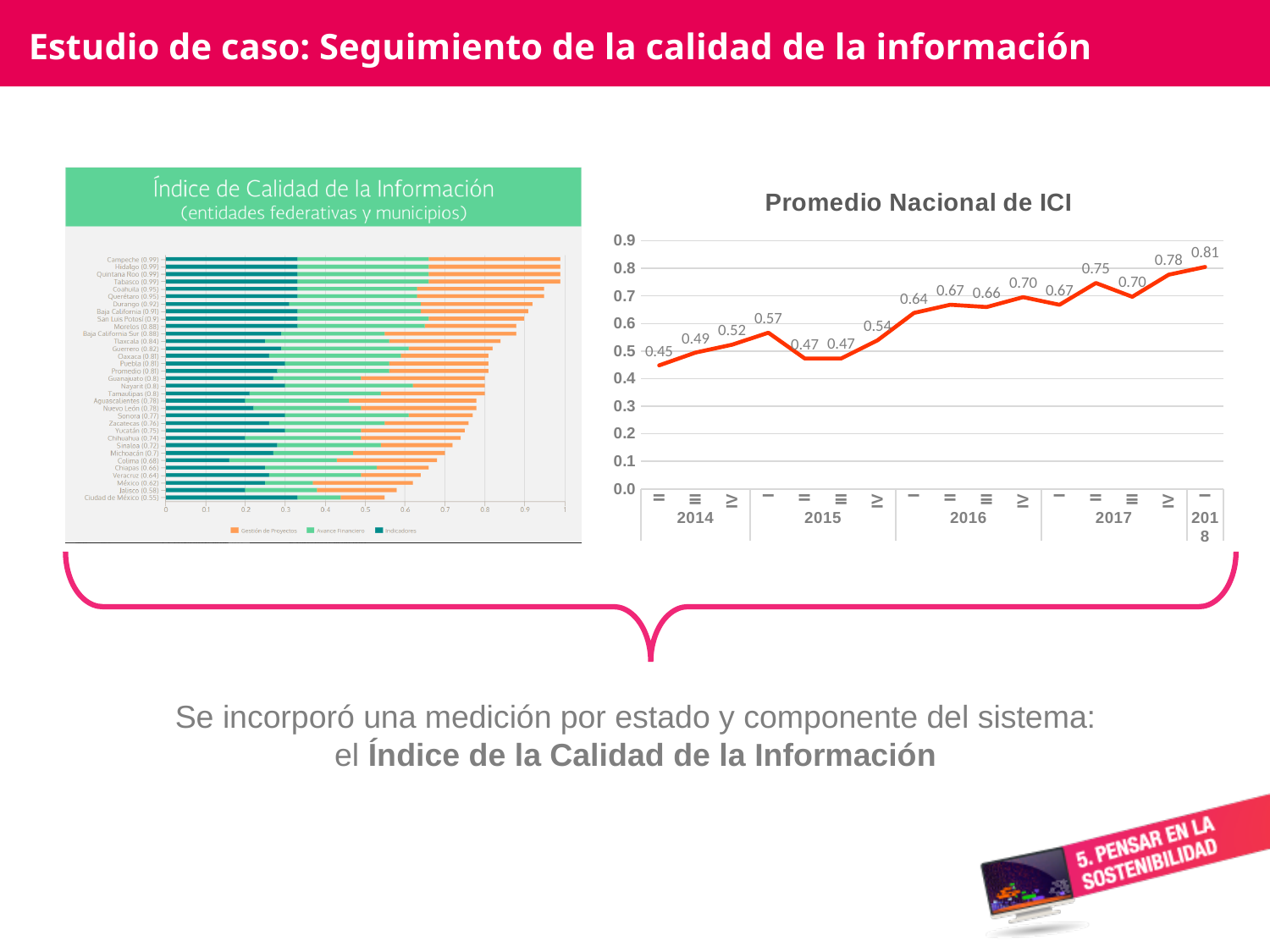
In the 'Promedio Nacional de ICI' chart, what is the value for quarter II of 2014? 0.45 In the 'Promedio Nacional de ICI' chart, what is the value for quarter I of 2018? 0.81 In the 'Promedio Nacional de ICI' chart, which point has the lowest value? II 2014 In the 'Promedio Nacional de ICI' chart, how many data points are plotted on the line? 16 What kind of chart is the left chart, 'Índice de Calidad de la Información'? Stacked bar chart In the 'Promedio Nacional de ICI' chart, which is larger: the value for quarter II of 2017 or the value for quarter III of 2017? II 2017 In the 'Promedio Nacional de ICI' chart, do the values generally rise or fall from 2014 to 2018? Rise What kind of chart is 'Promedio Nacional de ICI'? Line chart In the 'Promedio Nacional de ICI' chart, what is the value for quarter IV of 2016? 0.70 In the 'Promedio Nacional de ICI' chart, what is the difference between the value for quarter I of 2018 and the value for quarter II of 2014? 0.36 How many series does the legend of the left chart, 'Índice de Calidad de la Información', list? 3 In the 'Promedio Nacional de ICI' chart, which point has the highest value? I 2018